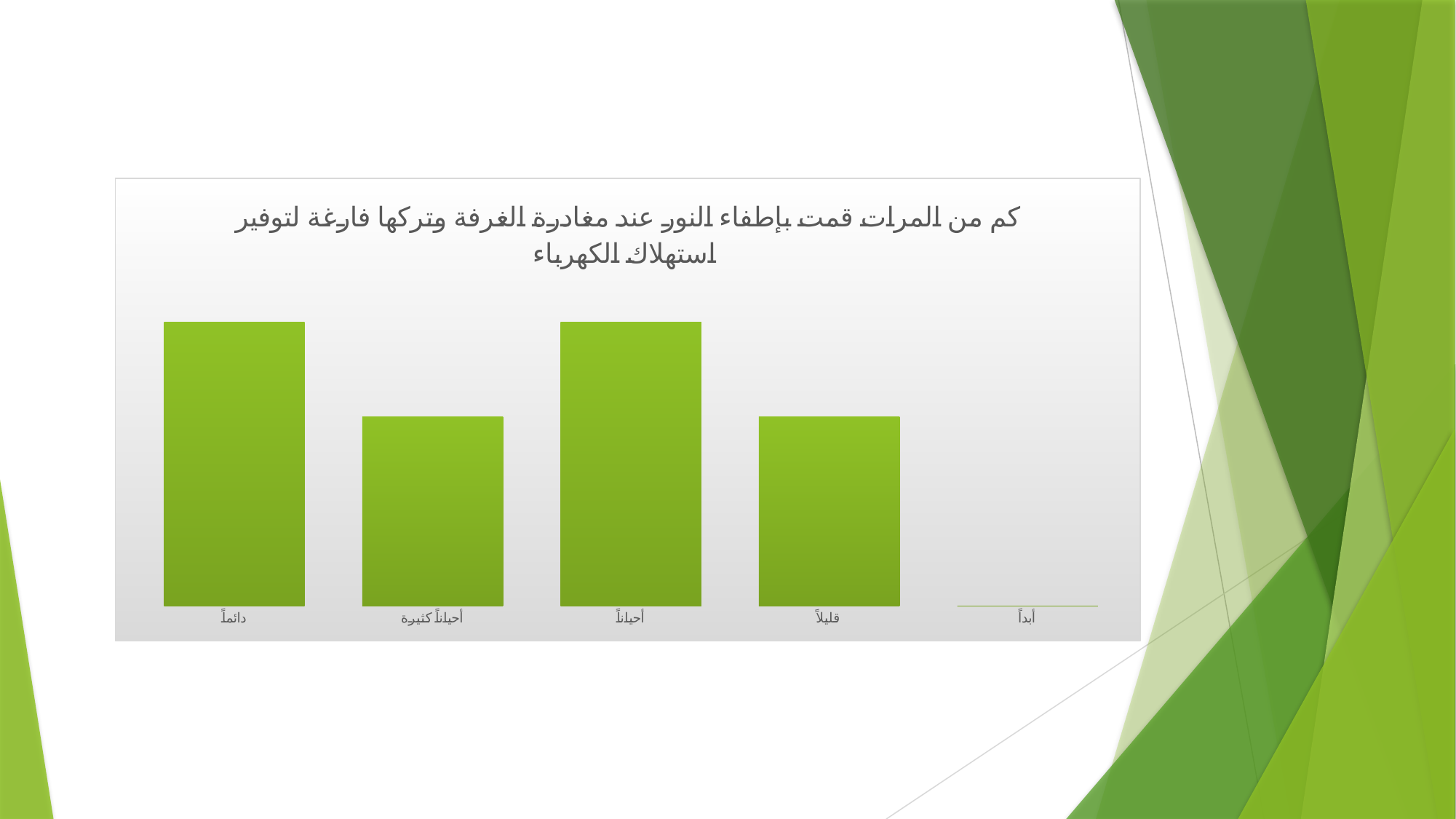
Which is larger, the value for قليلاً or the value for أبداً? قليلاً Which is larger, the value for أحياناً or the value for قليلاً? أحياناً Which is larger, the value for دائماً or the value for قليلاً? دائماً Which category has the lowest value in the chart? أبداً What colour are the bars in the chart? green How many categories are shown on the x axis of the chart? 5 What is the title of the chart? كم من المرات قمت بإطفاء النور عند مغادرة الغرفة وتركها فارغة لتوفير استهلاك الكهرباء What kind of chart is shown on the slide? bar chart